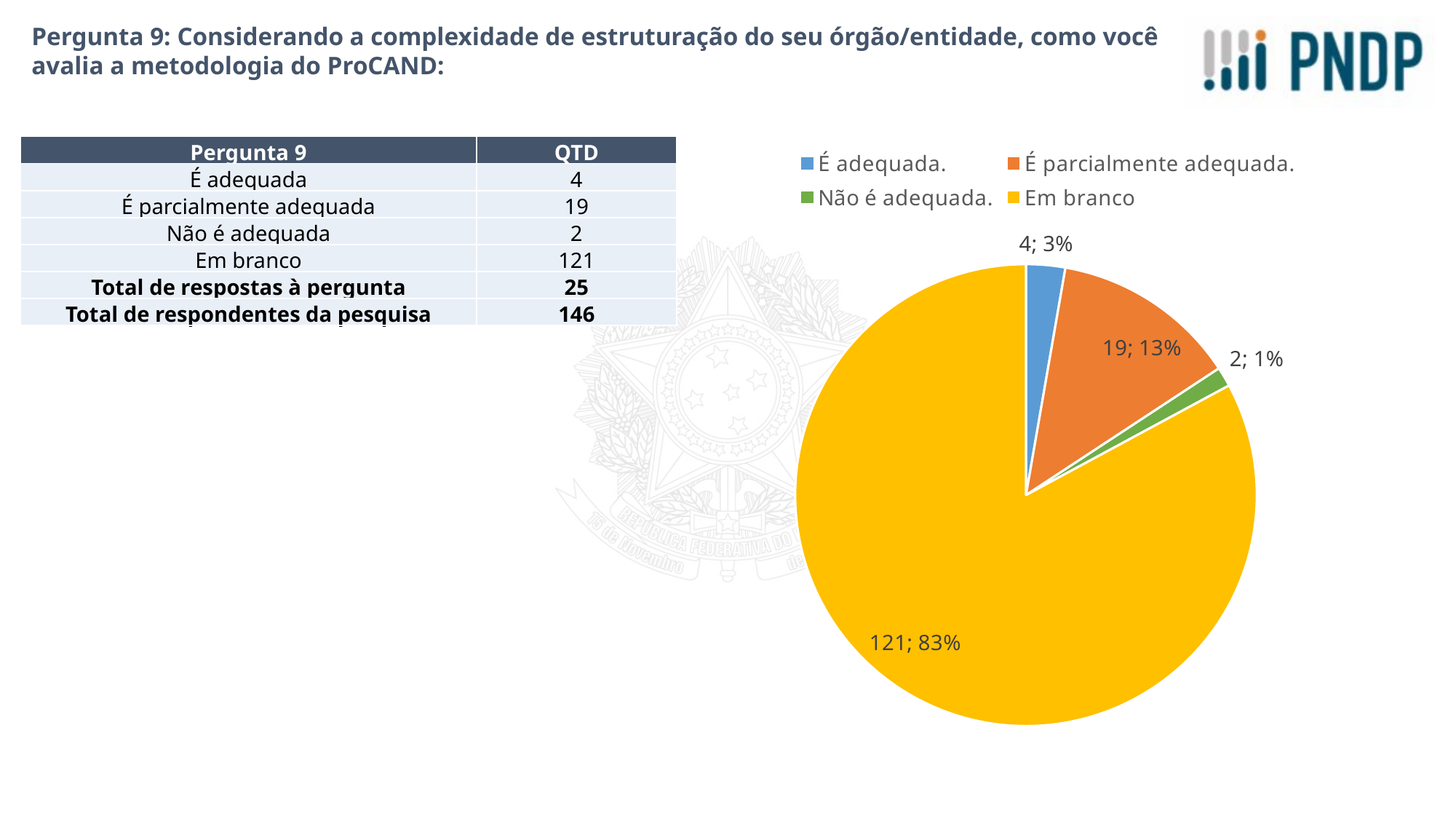
What is the difference between the values for 'É parcialmente adequada.' and 'É adequada.' in the pie chart? 15 What is the value shown for the 'É parcialmente adequada.' slice of the pie chart? 19 What is the value shown for the 'Em branco' slice of the pie chart? 121 Which slice of the pie chart is the smallest? Não é adequada. Which colour represents 'Em branco' in the pie chart? yellow Which slice of the pie chart is the largest? Em branco What is the value shown for the 'É adequada.' slice of the pie chart? 4 How many entries does the pie chart's legend list? 4 What percentage share does the 'Em branco' slice have in the pie chart? 83% What percentage share does the 'Não é adequada.' slice have in the pie chart? 1% How many slices does the pie chart have? 4 What kind of chart is shown on the slide? pie chart